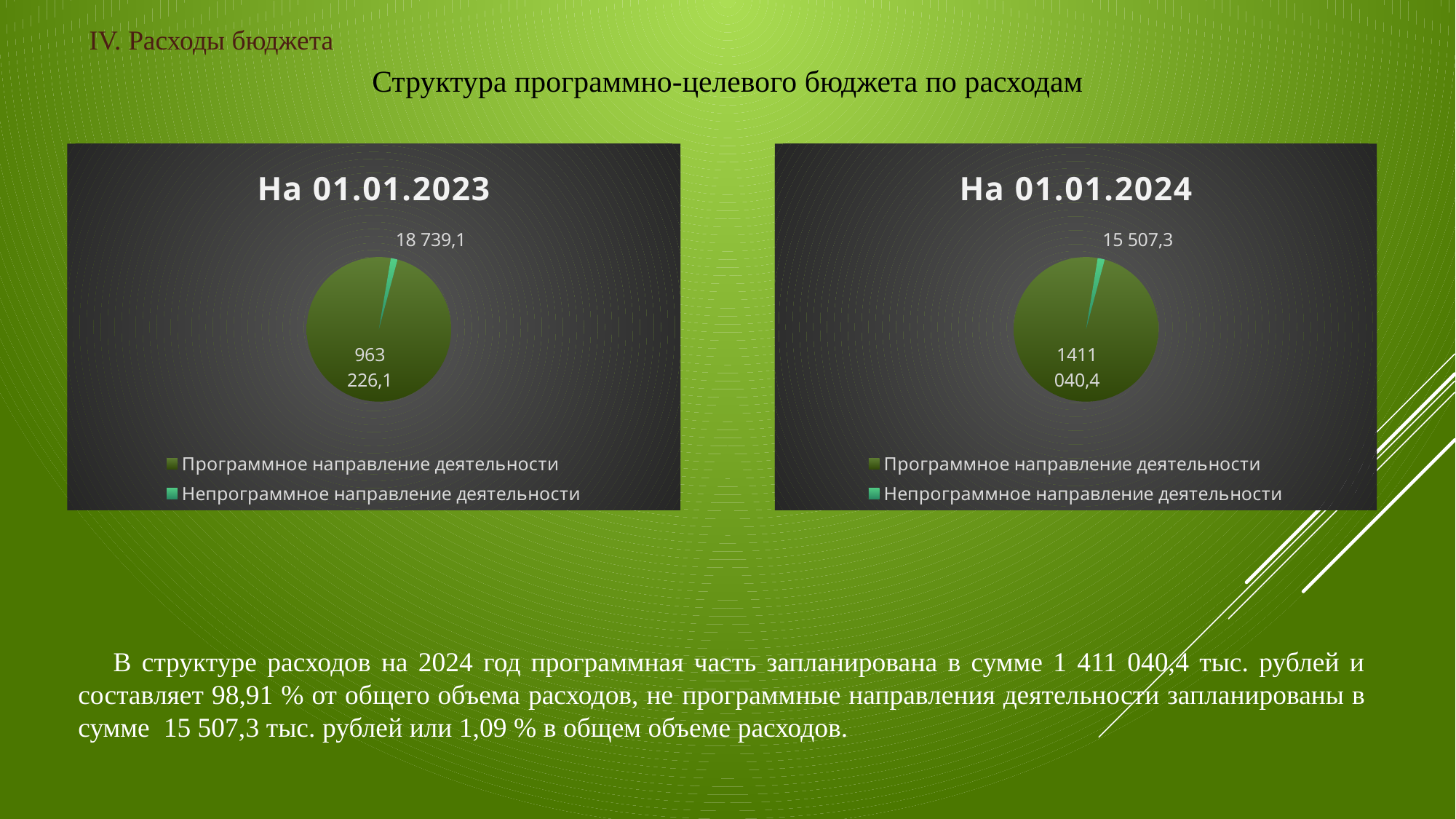
In the chart titled "На 01.01.2023", what is the value for Непрограммное направление деятельности? 18 739,1 In the chart titled "На 01.01.2023", what is the value for Программное направление деятельности? 963 226,1 What type of chart is used in the "На 01.01.2024" chart? Pie chart In the chart titled "На 01.01.2023", what is the difference between the Программное and Непрограммное values? 944 487,0 In the chart titled "На 01.01.2024", what share of the total does Непрограммное направление деятельности represent, as stated on the slide? 1,09 % Which is larger: Непрограммное направление деятельности in the "На 01.01.2023" chart or in the "На 01.01.2024" chart? На 01.01.2023 In the chart titled "На 01.01.2024", which category has the smallest slice? Непрограммное направление деятельности In the chart titled "На 01.01.2024", what is the total of the two slices? 1 426 547,7 In the chart titled "На 01.01.2024", what is the value for Непрограммное направление деятельности? 15 507,3 How many categories does the legend of the "На 01.01.2023" chart list? 2 In the chart titled "На 01.01.2024", what is the value for Программное направление деятельности? 1 411 040,4 In the chart titled "На 01.01.2023", which category has the largest slice? Программное направление деятельности